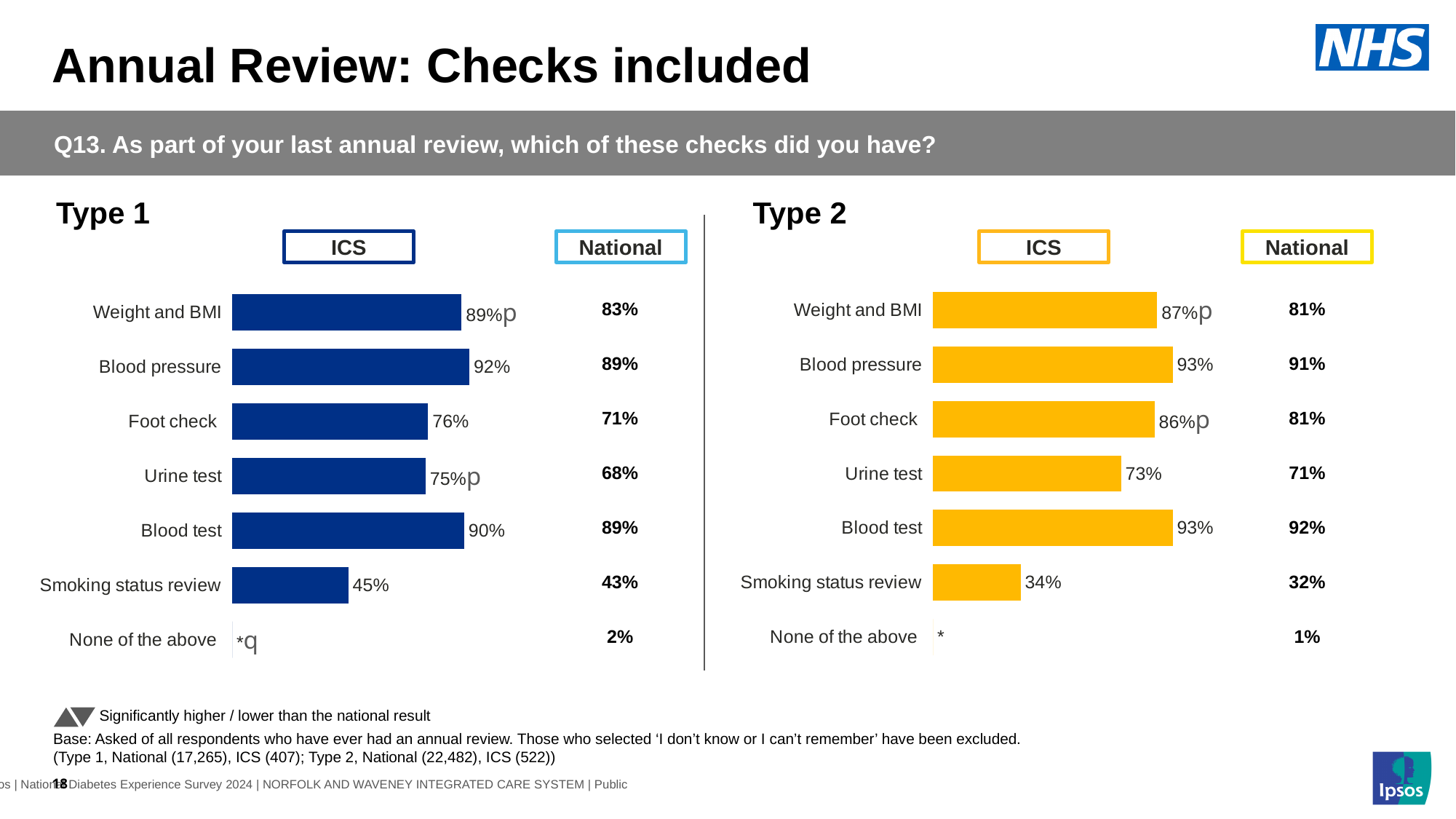
In the Type 2 chart, what is the ICS value for Smoking status review? 34% In the Type 1 chart, what is the ICS value for Blood pressure? 92% What type of chart is used for the Type 2 ICS results? Bar chart In the Type 1 chart, which check has the lowest ICS value among those with a bar shown? Smoking status review In the Type 2 chart, what is the difference between the ICS and National values for Foot check? 5 percentage points How many checks are listed in the Type 1 chart? 7 In the Type 1 chart, what is the National value for Urine test? 68% In the Type 2 chart, which check has the lowest National value? None of the above What colour are the ICS bars in the Type 2 chart? Yellow In the Type 2 chart, is the ICS value for Urine test higher or lower than the National value? higher In the Type 2 chart, what is the National value for Foot check? 81% In the Type 1 chart, what is the difference between the ICS and National values for Weight and BMI? 6 percentage points